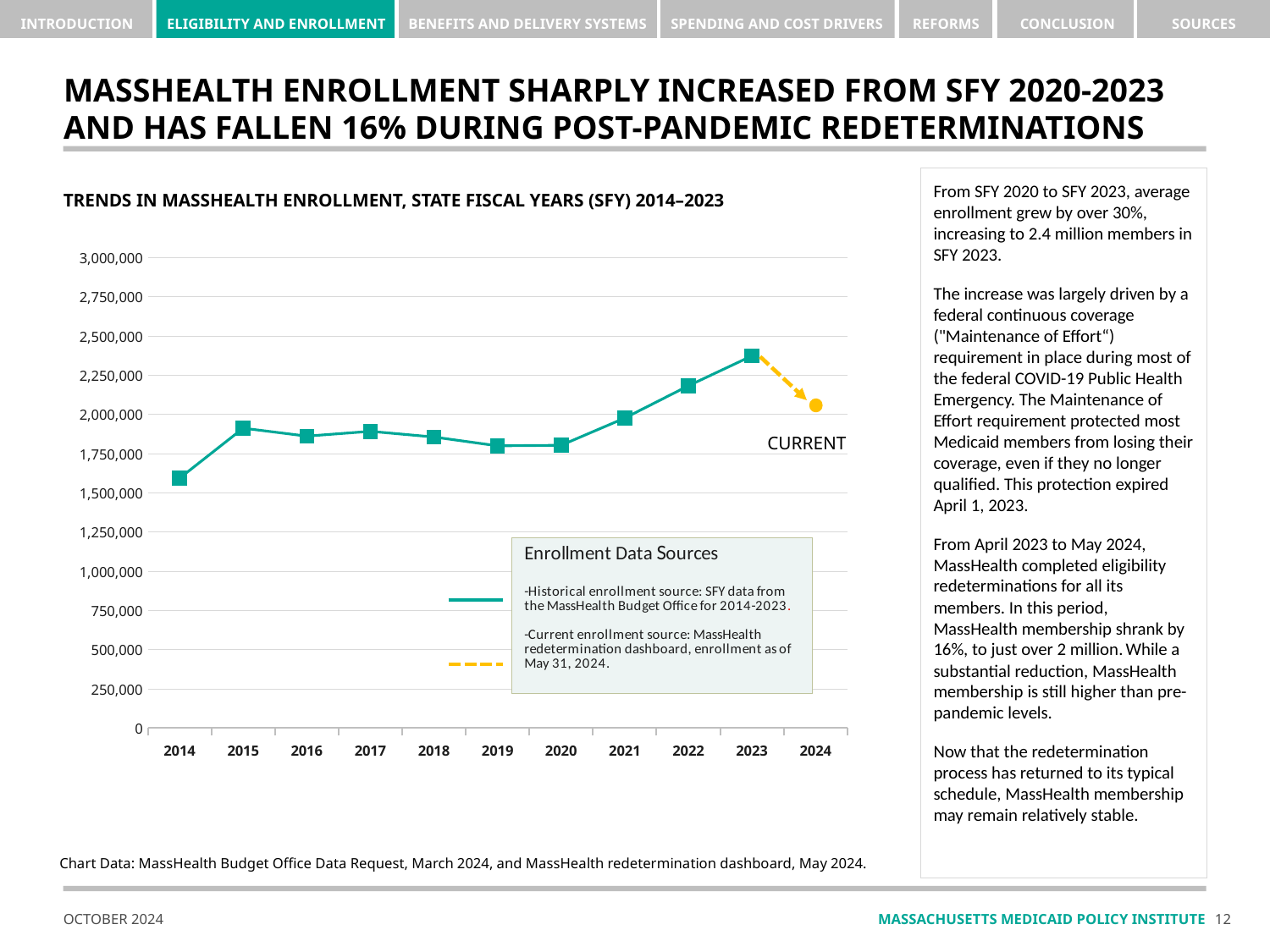
Is the enrollment value for 2024 greater or less than 2,250,000? less Is the enrollment value for 2014 greater or less than 1,750,000? less In which year is MassHealth enrollment highest on the chart? 2023 What is the title of the chart? Trends in MassHealth Enrollment, State Fiscal Years (SFY) 2014–2023 Do enrollment values rise or fall from 2020 to 2023? Rise What kind of chart is shown on the slide? Line chart What label is shown next to the dashed line leading to the 2024 point? CURRENT How many years are plotted along the x axis of the chart? 11 Is the enrollment value for 2022 greater or less than 2,000,000? greater Which year has higher enrollment, 2019 or 2022? 2022 In which year is MassHealth enrollment lowest on the chart? 2014